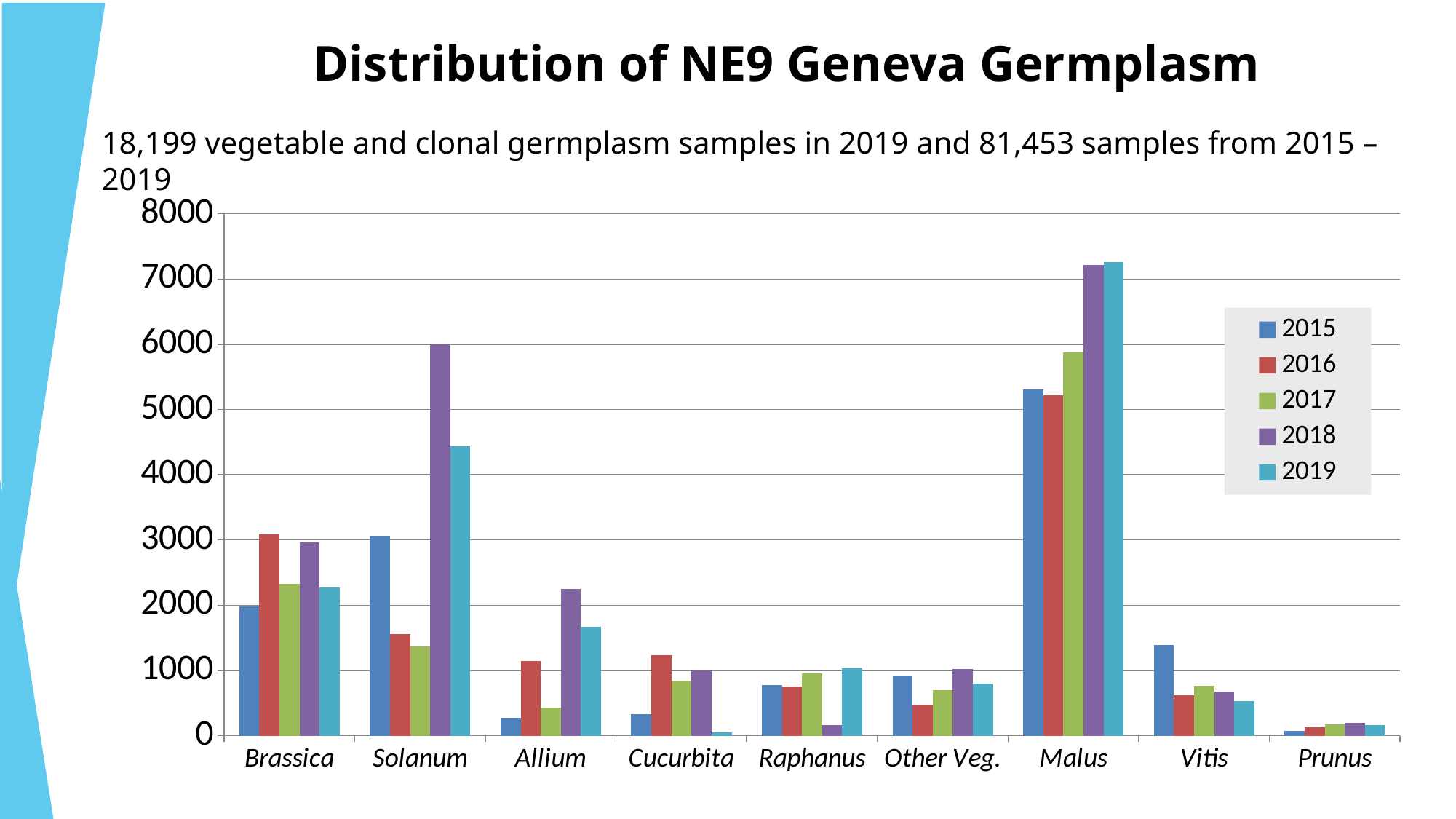
For Solanum, which year has the highest value? 2018 Which category has the highest value for 2019? Malus Is the value for Solanum in 2018 greater or less than 5000? greater For Brassica, which is larger: the value for 2015 or the value for 2016? 2016 Is the value for Vitis in 2015 greater or less than 1000? greater Which category has the lowest value for 2015? Prunus How many categories are shown on the x axis? 9 Is the value for Allium in 2018 greater or less than 2000? greater Which years are listed in the legend? 2015, 2016, 2017, 2018, 2019 How many series does the legend list? 5 What kind of chart is shown on the slide? bar chart